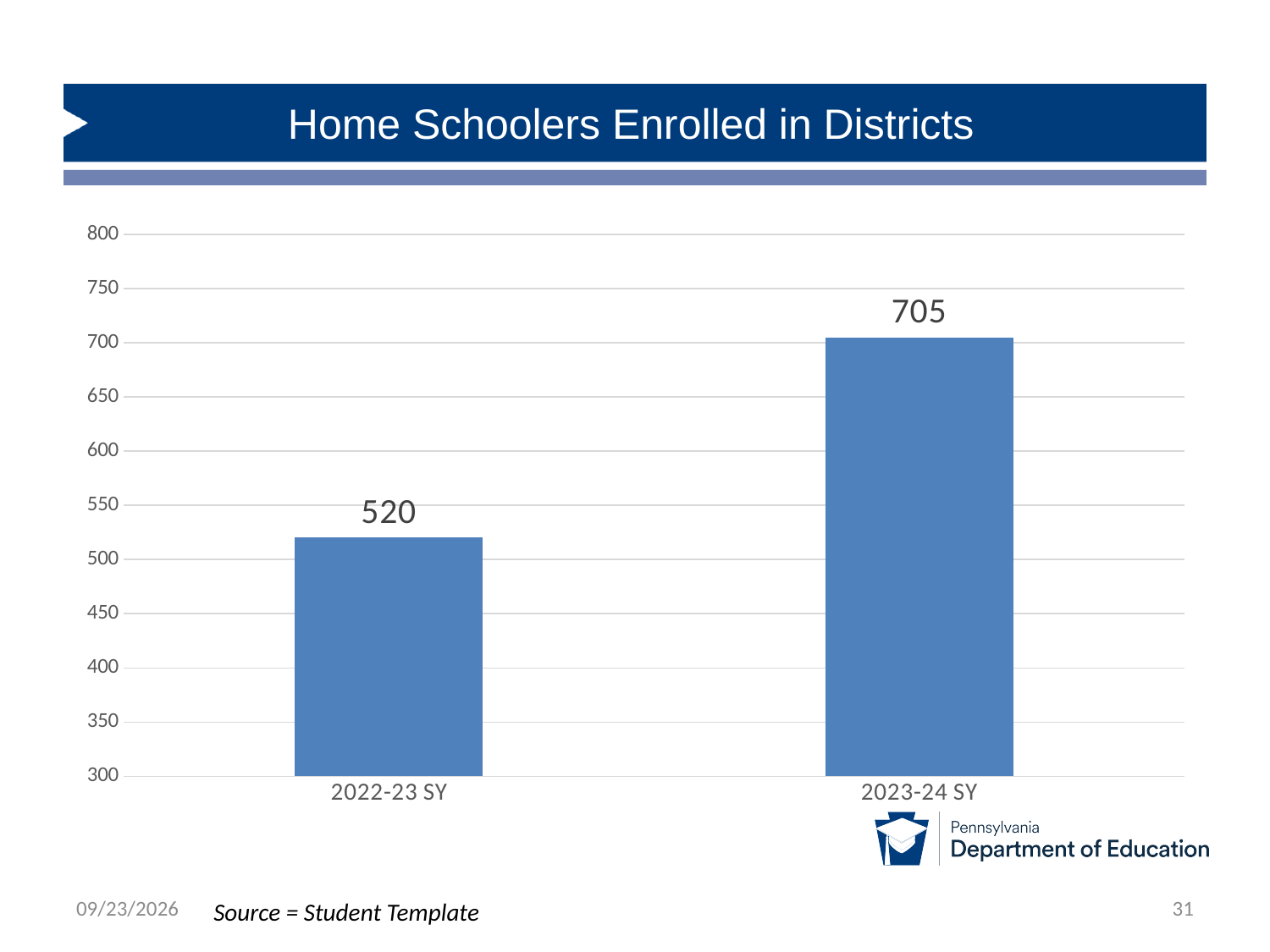
What kind of chart is shown on the slide? bar chart What is the difference between the values for 2023-24 SY and 2022-23 SY? 185 What is the value for 2022-23 SY? 520 Is the value for 2022-23 SY greater or less than 550? less Is the value for 2023-24 SY greater or less than 700? greater Do the values rise or fall from 2022-23 SY to 2023-24 SY? rise How many categories are shown on the x axis? 2 Which school year has the highest value? 2023-24 SY Which is larger, the value for 2022-23 SY or 2023-24 SY? 2023-24 SY What is the title of the slide? Home Schoolers Enrolled in Districts What is the value for 2023-24 SY? 705 Which school year has the lowest value? 2022-23 SY